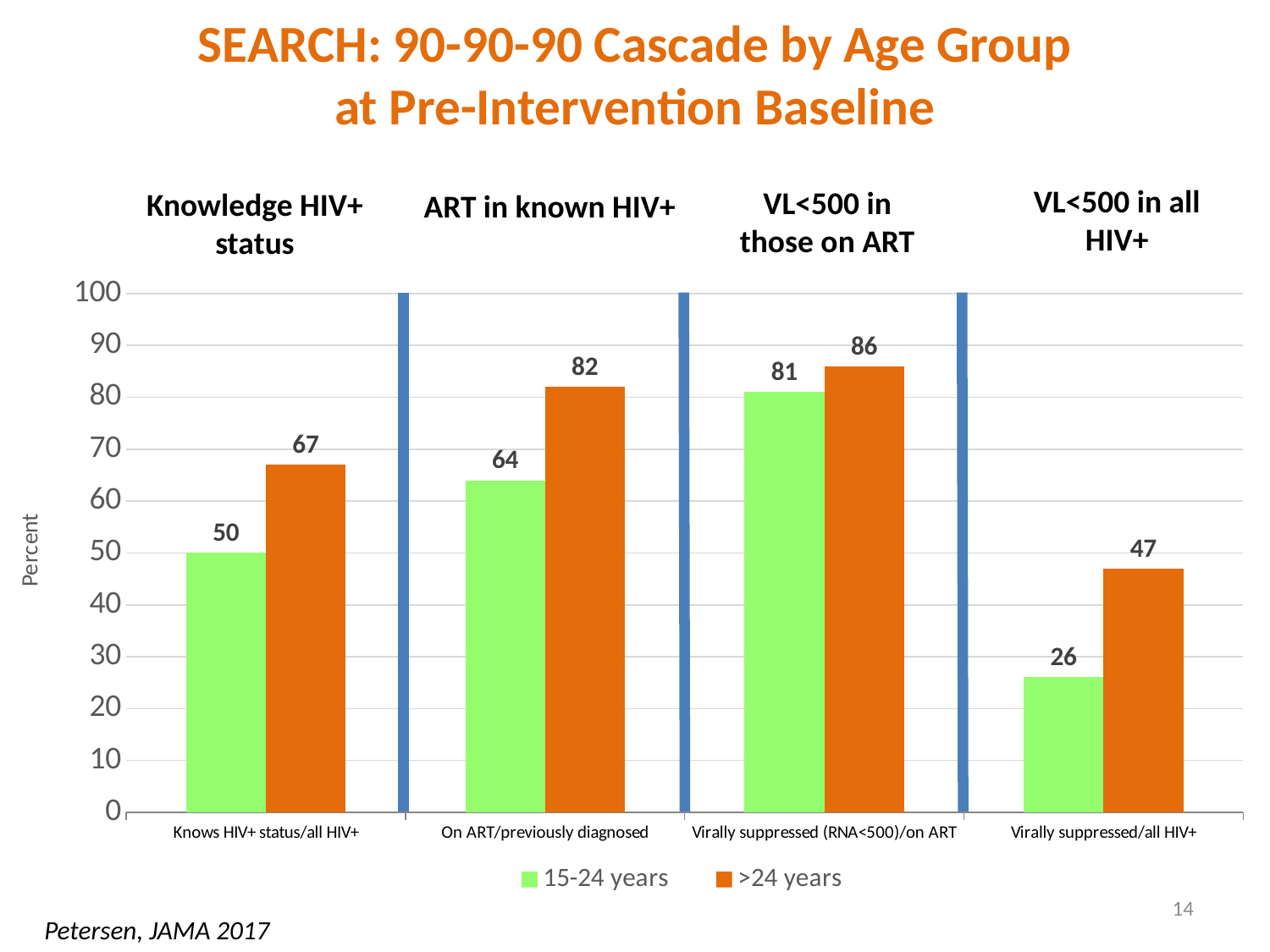
How many series does the legend list? 2 Which category has the highest value for the >24 years series? Virally suppressed (RNA<500)/on ART What is the value for >24 years in the 'On ART/previously diagnosed' category? 82 What is the label of the y axis? Percent What is the value for 15-24 years in the 'Virally suppressed/all HIV+' category? 26 What is the difference between the >24 years and 15-24 years values in the 'Virally suppressed/all HIV+' category? 21 What is the value for 15-24 years in the 'Knows HIV+ status/all HIV+' category? 50 What kind of chart is shown on the slide? bar chart Which category has the lowest value for the 15-24 years series? Virally suppressed/all HIV+ How many categories are shown on the x axis? 4 In the 'Knows HIV+ status/all HIV+' category, which series has the larger value, 15-24 years or >24 years? >24 years What is the difference between the >24 years and 15-24 years values in the 'Virally suppressed (RNA<500)/on ART' category? 5